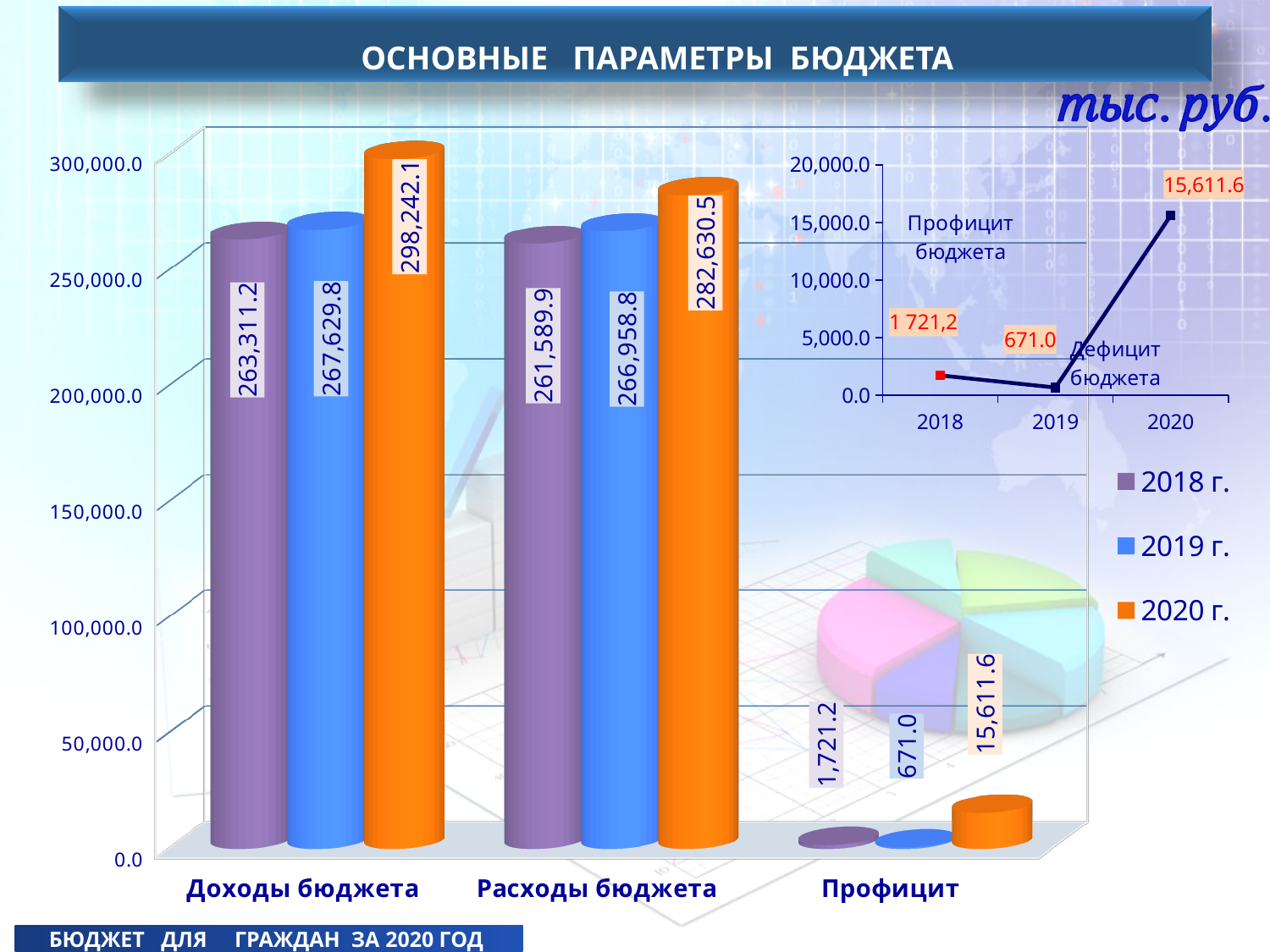
On the large bar chart, which year has the lowest value for Профицит? 2019 г. On the large bar chart, which year has the highest value for Доходы бюджета? 2020 г. On the large bar chart, is the value for Расходы бюджета in 2019 г. greater or less than 250,000.0? greater What kind of chart is the small chart in the upper right of the slide? line chart On the large bar chart, how many categories are shown on the x axis? 3 On the small line chart in the upper right, what is the value for 2020? 15,611.6 On the large bar chart, how many series does the legend list? 3 On the large bar chart, what is the value for Расходы бюджета in 2018 г.? 261,589.9 On the large bar chart, what is the value for Доходы бюджета in 2020 г.? 298,242.1 On the large bar chart, what is the value for Профицит in 2019 г.? 671.0 On the large bar chart, what is the difference between Доходы бюджета and Расходы бюджета in 2020 г.? 15,611.6 On the large bar chart, which is larger in 2019 г.: Доходы бюджета or Расходы бюджета? Доходы бюджета